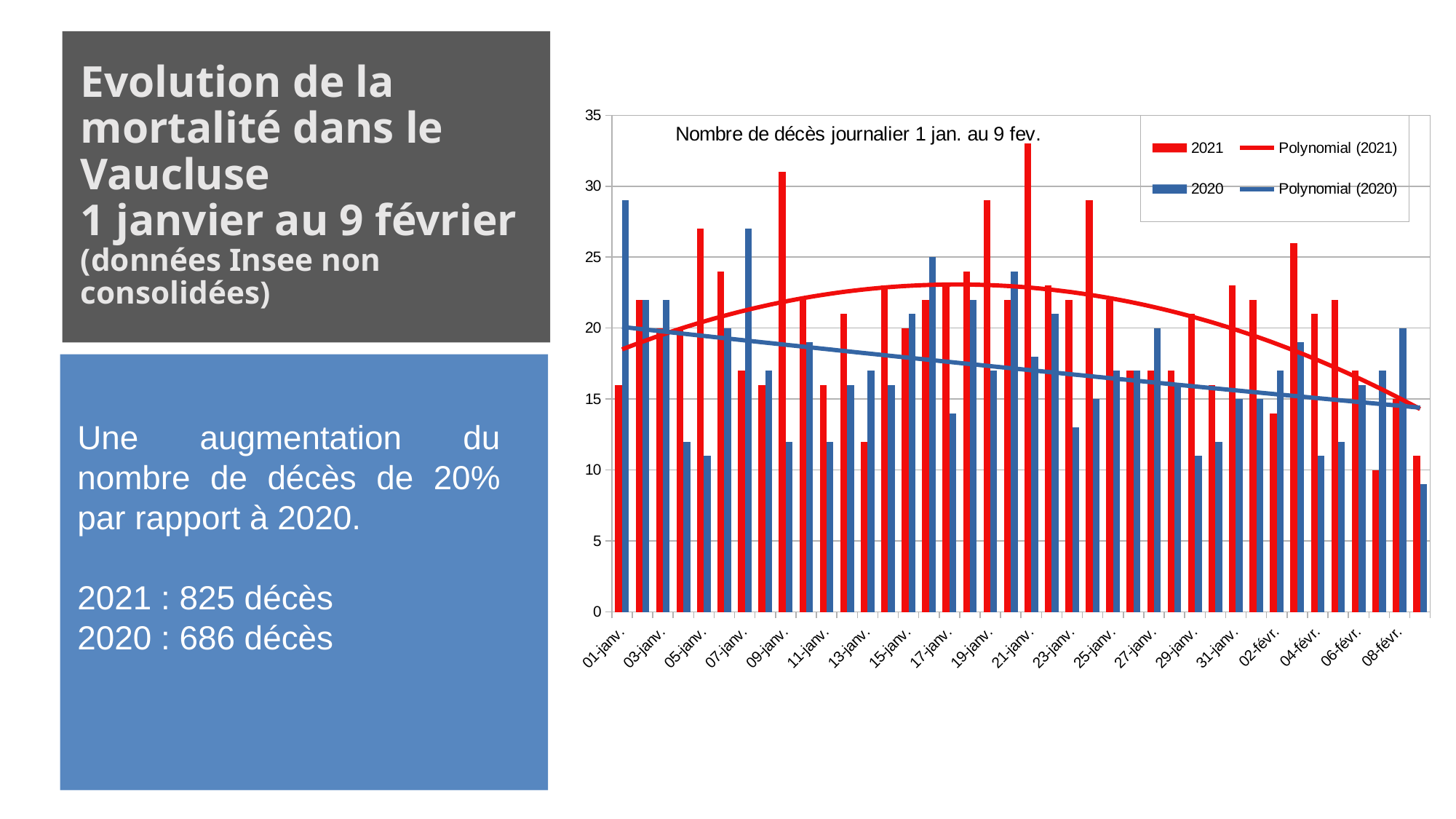
What is the title of the chart? Nombre de décès journalier 1 jan. au 9 fev. On 21-janv., which series has the larger value, 2020 or 2021? 2021 Is the 2021 value for 21-janv. greater or less than 30? greater Does the Polynomial (2020) trend line rise or fall from left to right? fall Which colour represents the 2021 series in the chart? red On 01-janv., which series has the larger value, 2020 or 2021? 2020 How many dates are labelled on the x axis of the chart? 20 Is the 2020 value for 01-janv. greater or less than 25? greater Is the 2021 value for 09-janv. greater or less than 25? greater How many entries does the chart legend list? 4 What kind of chart is shown on the slide? bar chart